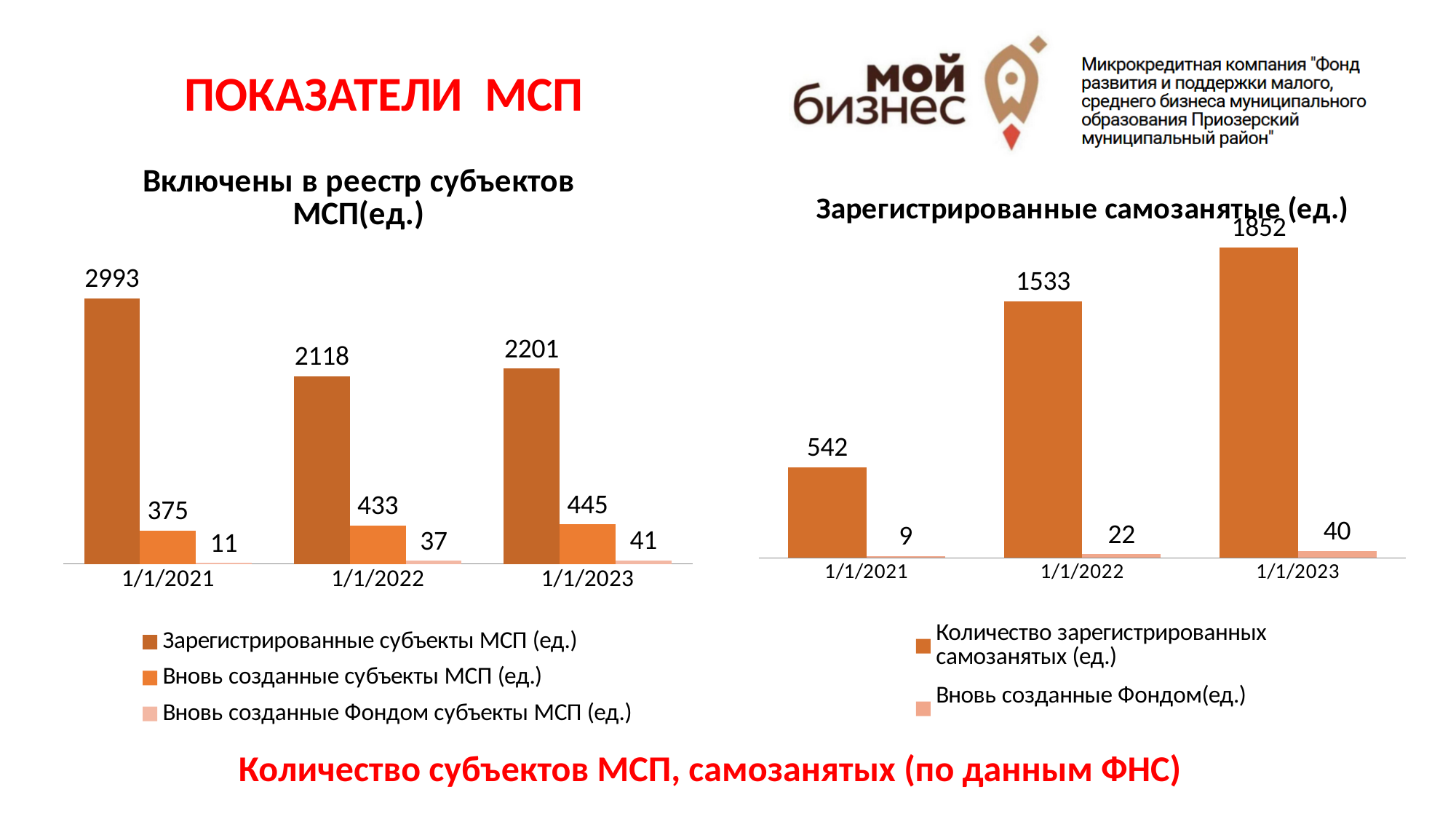
In the chart 'Зарегистрированные самозанятые (ед.)', does the 'Количество зарегистрированных самозанятых (ед.)' series rise or fall from 1/1/2021 to 1/1/2023? rise In the chart 'Зарегистрированные самозанятые (ед.)', which date has the highest value for 'Количество зарегистрированных самозанятых (ед.)'? 1/1/2023 In the chart 'Включены в реестр субъектов МСП(ед.)', how many series does the legend list? 3 What kind of chart is 'Зарегистрированные самозанятые (ед.)'? bar chart In the chart 'Включены в реестр субъектов МСП(ед.)', which date has the lowest value for 'Зарегистрированные субъекты МСП (ед.)'? 1/1/2022 In the chart 'Включены в реестр субъектов МСП(ед.)', what is the value of 'Вновь созданные субъекты МСП (ед.)' for 1/1/2022? 433 In the chart 'Включены в реестр субъектов МСП(ед.)', what is the value of 'Зарегистрированные субъекты МСП (ед.)' for 1/1/2021? 2993 In the chart 'Зарегистрированные самозанятые (ед.)', what is the value of 'Количество зарегистрированных самозанятых (ед.)' for 1/1/2022? 1533 In the chart 'Зарегистрированные самозанятые (ед.)', what is the value of 'Вновь созданные Фондом(ед.)' for 1/1/2021? 9 In the chart 'Включены в реестр субъектов МСП(ед.)', what is the value of 'Вновь созданные Фондом субъекты МСП (ед.)' for 1/1/2023? 41 In the chart 'Включены в реестр субъектов МСП(ед.)', what is the difference between the 'Зарегистрированные субъекты МСП (ед.)' values for 1/1/2021 and 1/1/2023? 792 In the chart 'Зарегистрированные самозанятые (ед.)', what is the difference between the 'Вновь созданные Фондом(ед.)' values for 1/1/2023 and 1/1/2022? 18